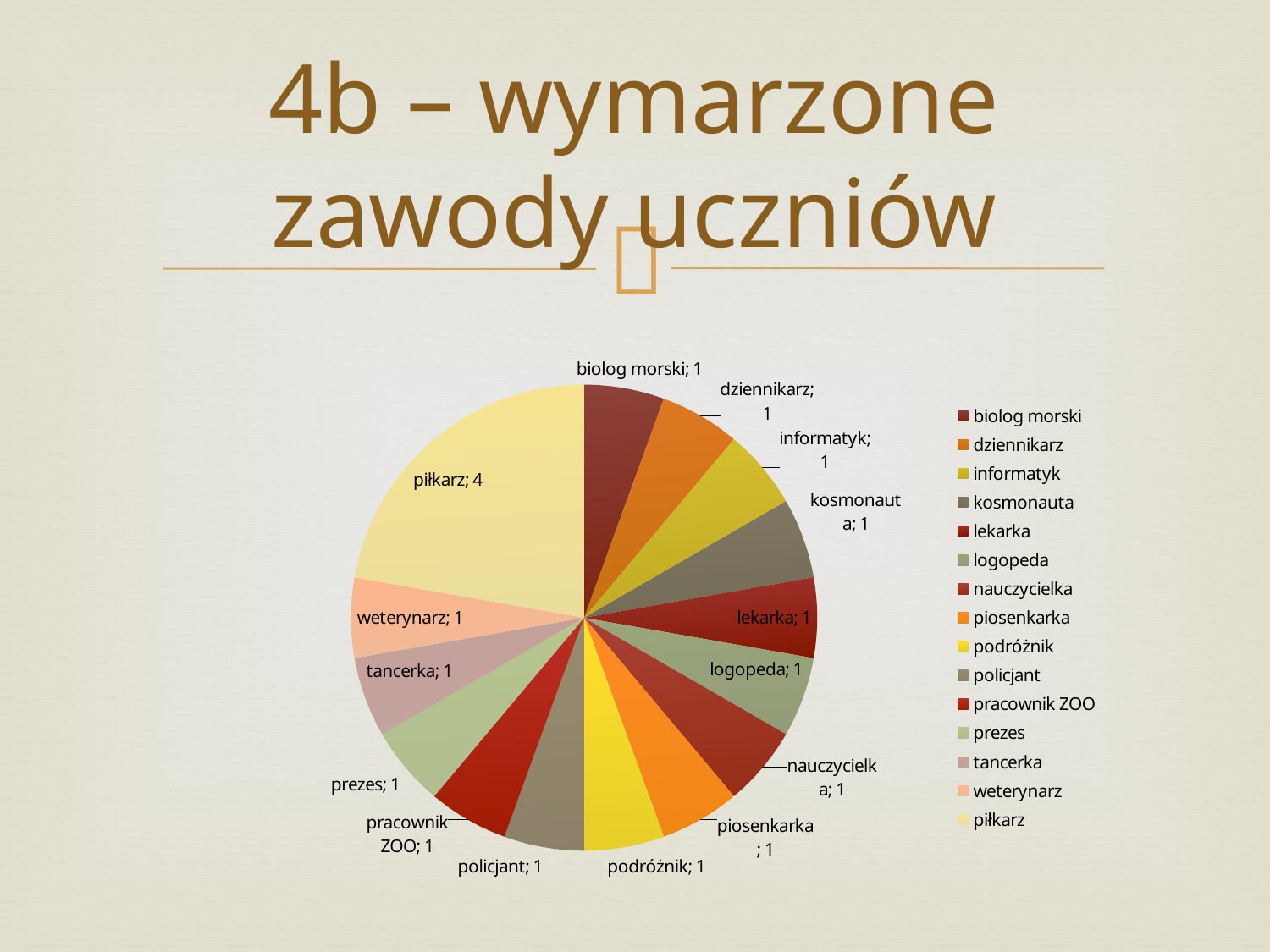
What is the title of the slide containing the chart? 4b – wymarzone zawody uczniów What is the value for piłkarz? 4 How many entries does the legend list? 15 What is the value for pracownik ZOO? 1 What is the difference between the value for piłkarz and the value for weterynarz? 3 What is the value for lekarka? 1 What kind of chart is shown on the slide? pie chart How many categories does the pie chart have? 15 Which legend entry is listed last? piłkarz What is the total of all the values in the pie chart? 18 Which is larger, the value for piłkarz or the value for policjant? piłkarz Which category has the largest slice of the pie? piłkarz